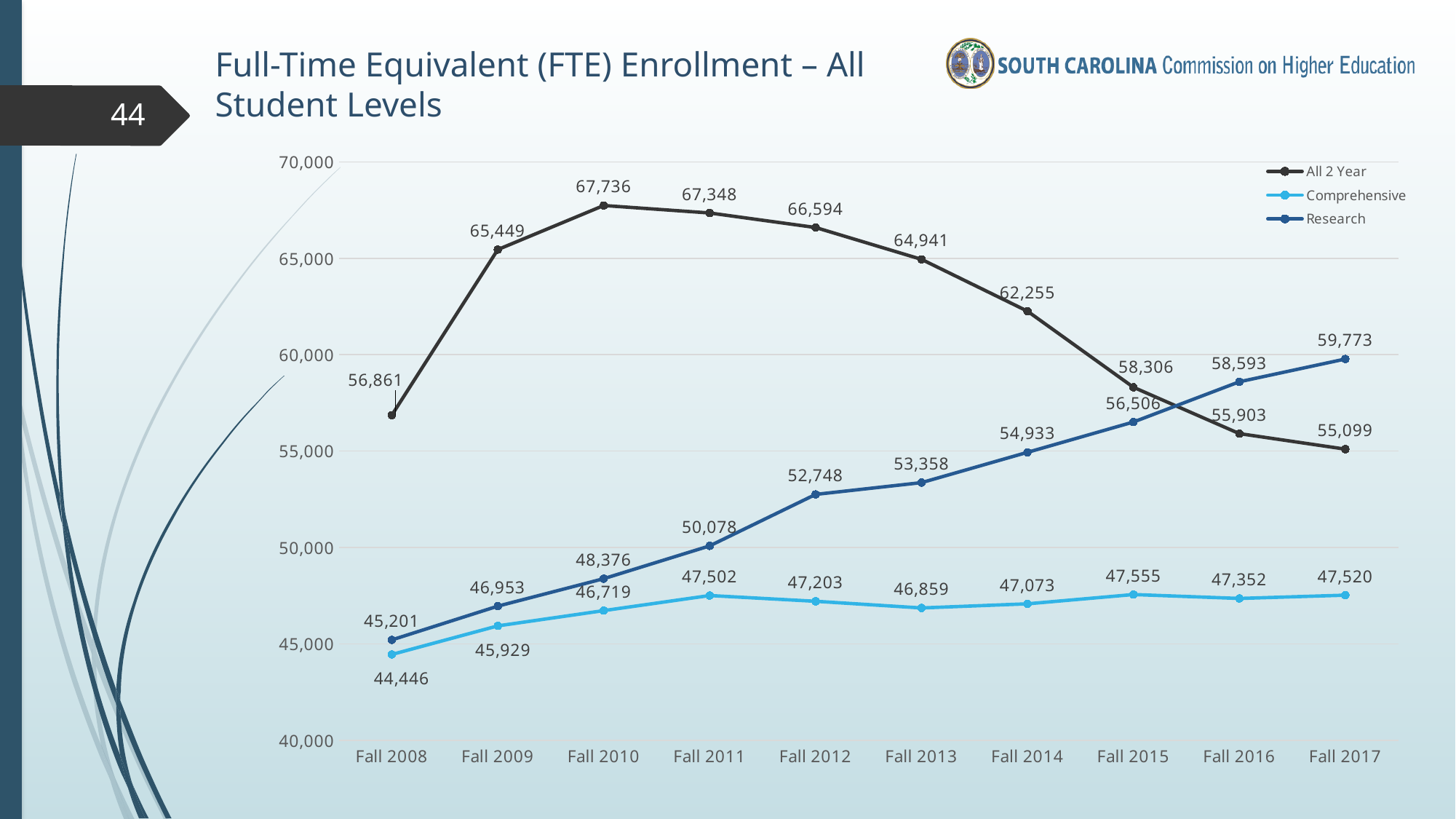
How much did the All 2 Year value fall from Fall 2010 to Fall 2017? 12,637 How many series does the legend list? 3 What is the difference between the Research value and the All 2 Year value in Fall 2017? 4,674 What is the Comprehensive FTE enrollment value for Fall 2008? 44,446 Does the Research series rise or fall from Fall 2008 to Fall 2017? Rise In which fall term does the All 2 Year series reach its highest value? Fall 2010 What kind of chart is shown on the slide? Line chart Which is larger in Fall 2016, the Research value or the All 2 Year value? Research In which fall term is the Comprehensive series at its lowest value? Fall 2008 How many fall terms are shown on the x axis? 10 What is the Research FTE enrollment value for Fall 2017? 59,773 What is the All 2 Year FTE enrollment value for Fall 2010? 67,736